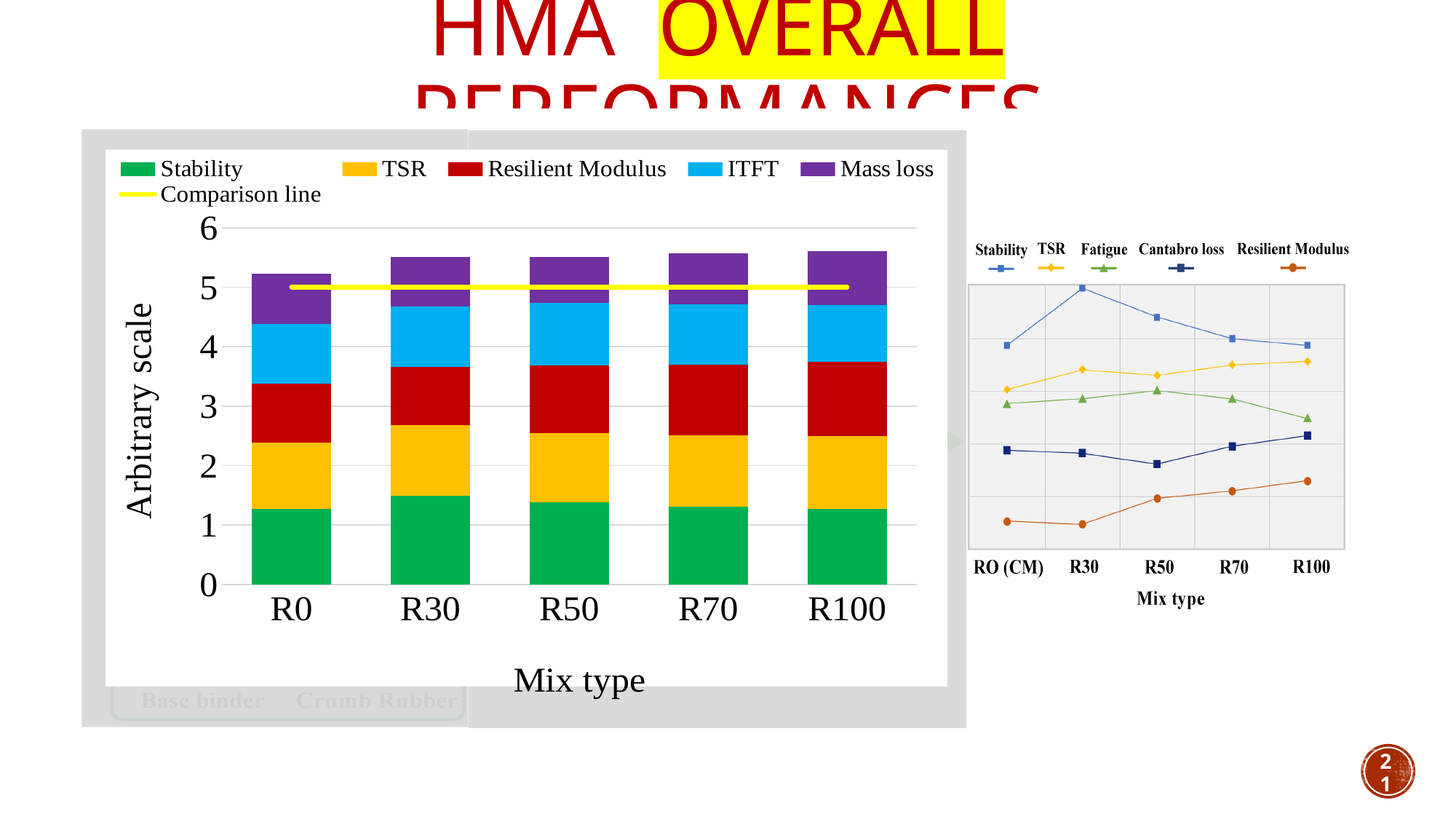
In the right line chart, at which mix type does the Stability series reach its highest point? R30 In the left stacked bar chart, which mix type has the lowest total stacked bar? R0 What kind of chart is the right chart with the 'Mix type' axis and markers? line chart In the left stacked bar chart, how many entries does the legend list? 6 In the left stacked bar chart, how many mix types are shown on the x axis? 5 In the left stacked bar chart, what is the label of the x axis? Mix type In the right line chart, does the Resilient Modulus series generally rise or fall from R30 to R100? rise In the left stacked bar chart, is the total stacked value for R0 greater or less than 5? greater In the right line chart, how many series does the legend list? 5 In the left stacked bar chart, at what value on the Arbitrary scale is the yellow Comparison line drawn? 5 In the left stacked bar chart, is the Stability segment for R30 greater or less than 1? greater What kind of chart is the left chart with the 'Arbitrary scale' axis? stacked bar chart